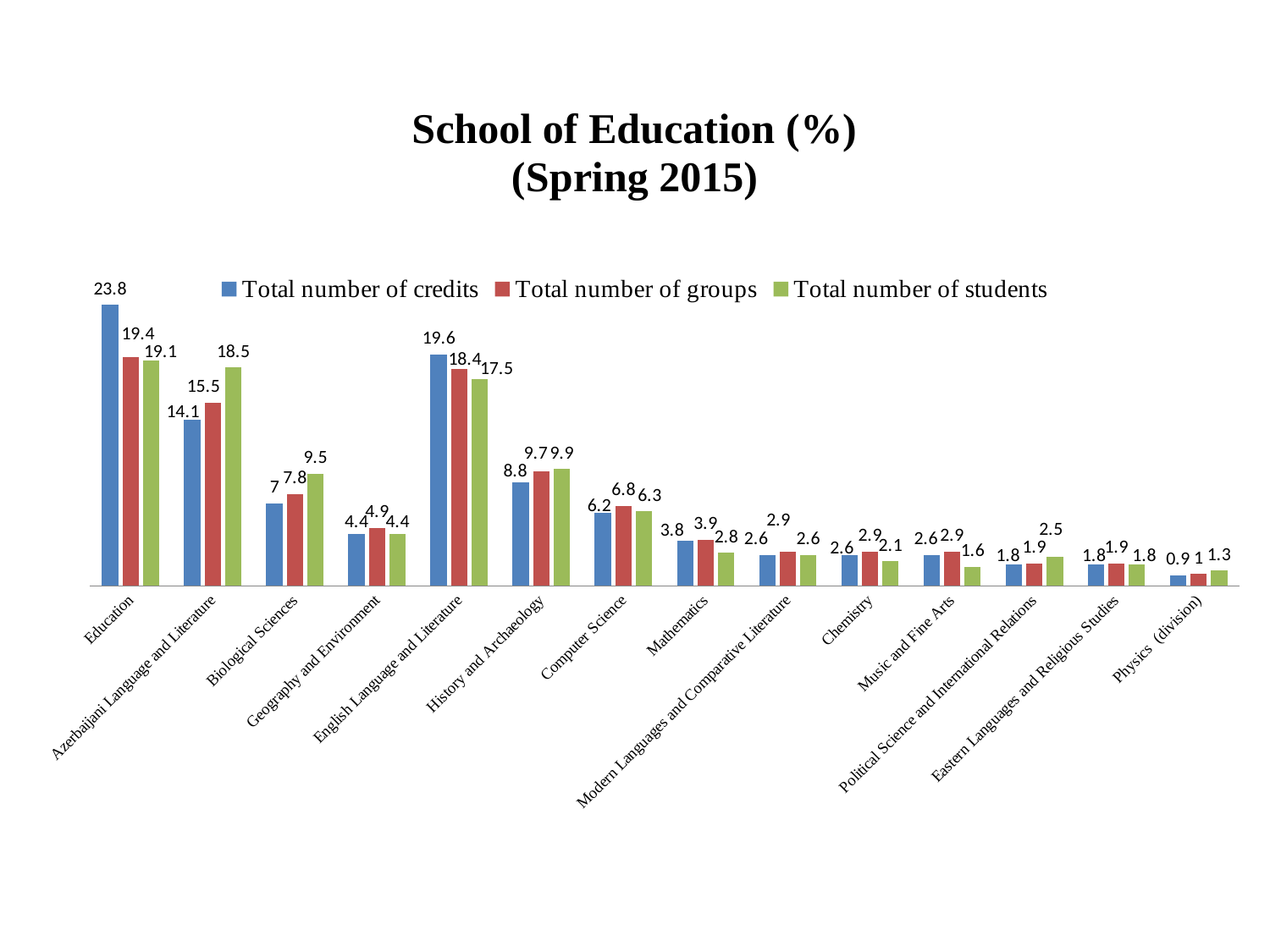
What is the difference between Total number of credits and Total number of students for Education? 4.7 Which category has the highest value for Total number of credits? Education Which category has the lowest value for Total number of groups? Physics (division) Which is larger for Biological Sciences: Total number of credits or Total number of students? Total number of students What is the value for Total number of students for Physics (division)? 1.3 What is the value for Total number of groups for English Language and Literature? 18.4 What is the title of the chart? School of Education (%) (Spring 2015) What is the value for Total number of credits for Education? 23.8 How many series does the legend list? 3 What kind of chart is shown on the slide? Bar chart What is the value for Total number of students for Azerbaijani Language and Literature? 18.5 How many categories are shown on the x axis? 14